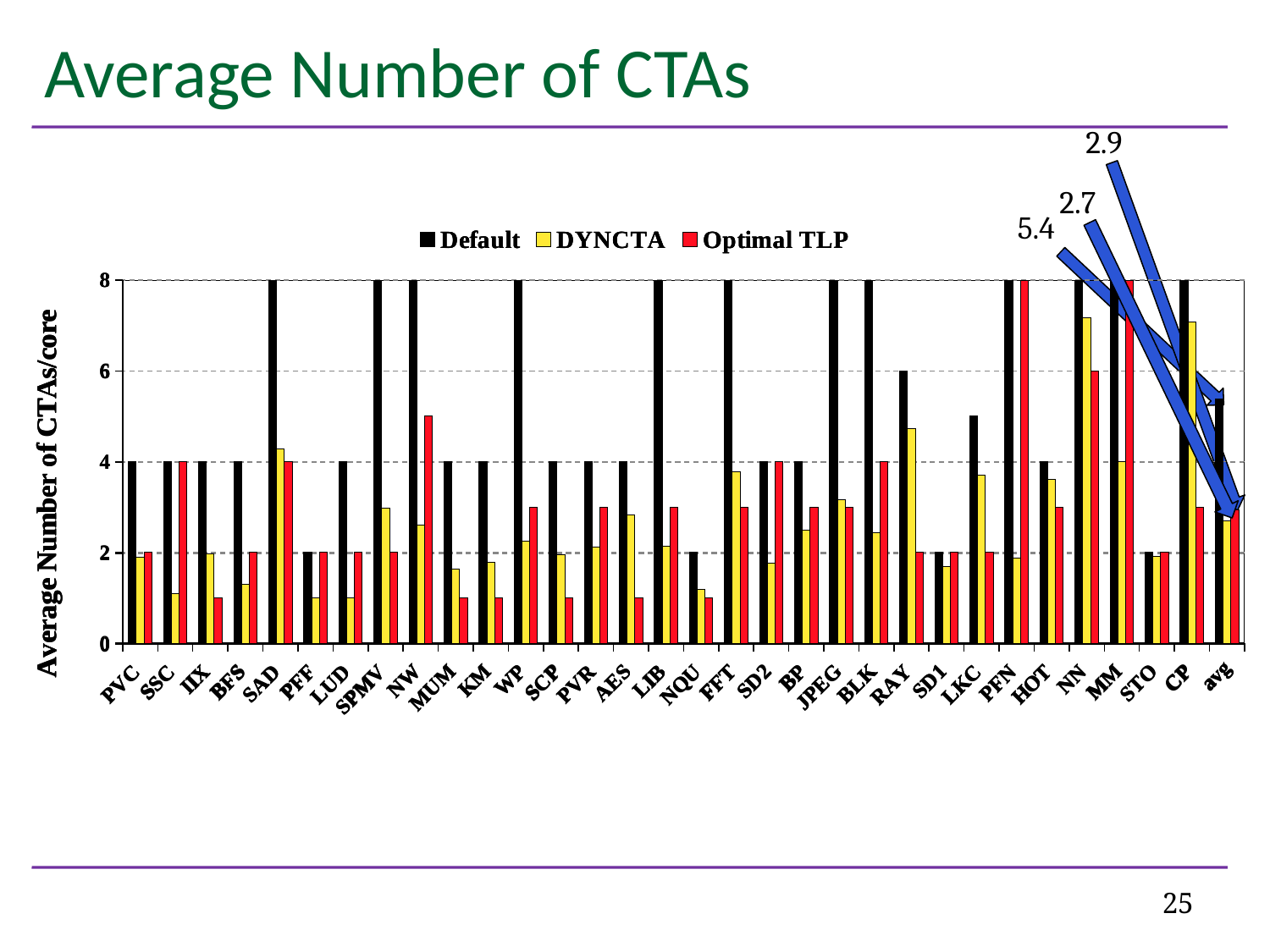
Is the Optimal TLP value for SPMV greater or less than 4? less What is the Default value for the avg category, as annotated on the slide? 5.4 What is the difference between the annotated Default and DYNCTA values for avg? 2.7 For NW, which is larger: the DYNCTA value or the Optimal TLP value? Optimal TLP How many series does the legend list? 3 Is the DYNCTA value for NN greater or less than 6? greater How many categories are shown along the x axis? 32 What is the DYNCTA value for the avg category, as annotated on the slide? 2.7 What is the Default value for SAD? 8 What is the Optimal TLP value for the avg category, as annotated on the slide? 2.9 What kind of chart is shown on the slide? bar chart